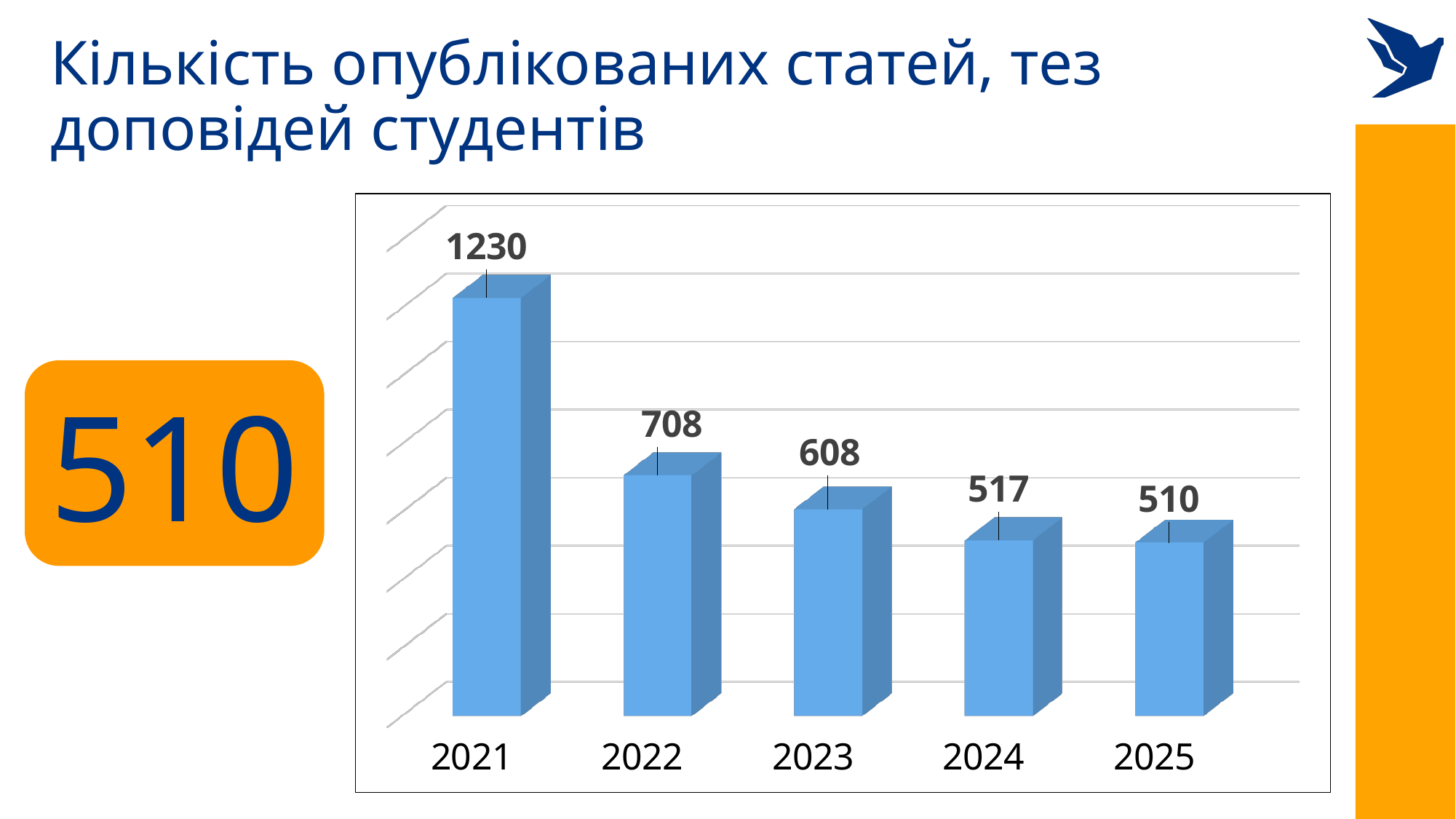
Which year has the lowest value? 2025 What is the value for 2023? 608 What is the title of the slide? Кількість опублікованих статей, тез доповідей студентів What is the value for 2021? 1230 How many years are shown on the x axis? 5 Do the values rise or fall from 2021 to 2025? fall Which is larger, the value for 2022 or the value for 2023? 2022 Which year has the highest value? 2021 What is the difference between the values for 2023 and 2024? 91 What is the value for 2025? 510 What kind of chart is shown? bar chart What is the difference between the values for 2021 and 2022? 522